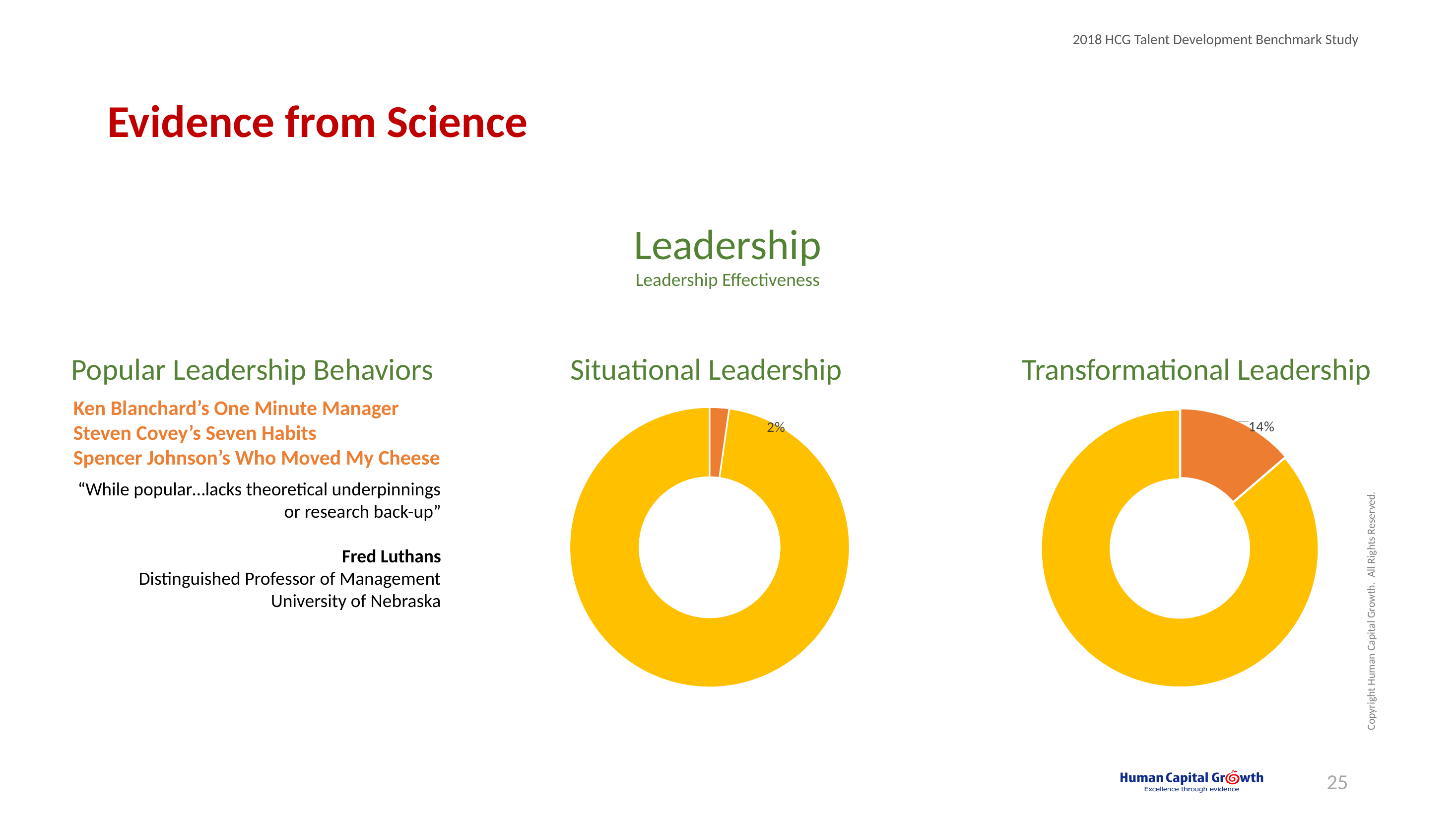
Which chart has the larger labelled orange slice, Situational Leadership or Transformational Leadership? Transformational Leadership What kind of chart is used for Situational Leadership? Donut (pie) chart In the Transformational Leadership chart, is the orange slice greater or less than 50% of the chart? less How many slices does the Situational Leadership donut chart have? 2 In the Transformational Leadership chart, what share of the whole does the orange slice represent? 14% What is the difference between the labelled slice in the Transformational Leadership chart and the labelled slice in the Situational Leadership chart? 12% What colour is the slice that carries the percentage label in both donut charts? Orange What is the title of the chart on the right side of the slide? Transformational Leadership In the Situational Leadership chart, what share of the whole does the orange slice represent? 2% In the Transformational Leadership chart, what percentage is shown on the orange slice? 14% How many slices does the Transformational Leadership donut chart have? 2 In the Situational Leadership chart, what percentage is shown on the orange slice? 2%